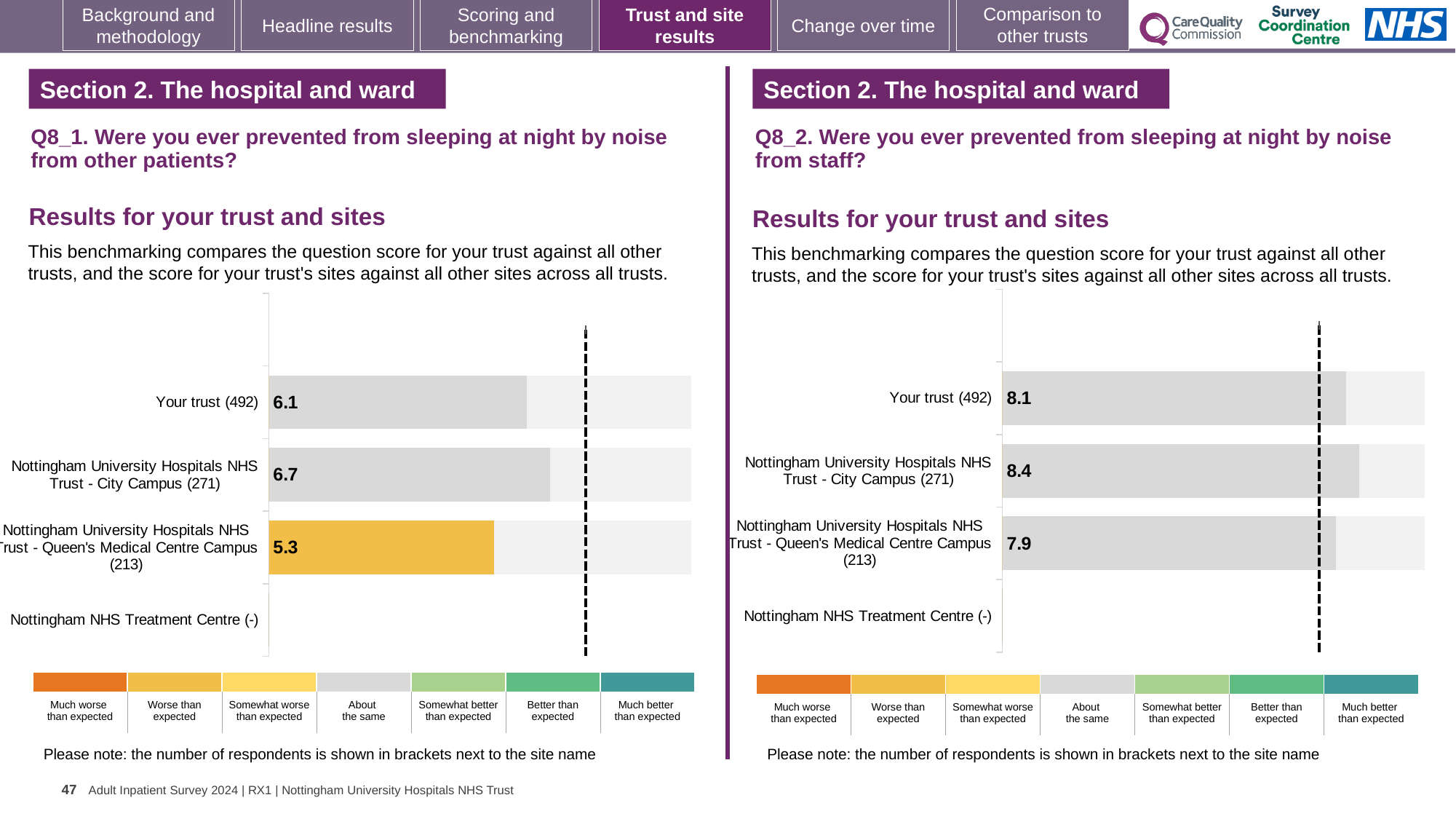
On the Q8_2 chart (noise from staff), what is the difference between the City Campus score and Your trust score? 0.3 On the Q8_1 chart (noise from other patients), which site or trust has the highest score? Nottingham University Hospitals NHS Trust - City Campus (271) How many rows (sites or trust) are listed on the Q8_2 chart (noise from staff)? 4 What kind of chart is used on the left-hand Q8_1 chart? Bar chart On the Q8_1 chart (noise from other patients), which is larger: the score for Your trust or the score for Queen's Medical Centre Campus? Your trust On the Q8_1 chart (noise from other patients), what is the score for Your trust (492)? 6.1 On the Q8_1 chart (noise from other patients), what is the difference between the City Campus score and the Queen's Medical Centre Campus score? 1.4 On the Q8_1 chart (noise from other patients), which bar is coloured yellow/orange rather than grey? Nottingham University Hospitals NHS Trust - Queen's Medical Centre Campus (213) On the Q8_1 chart (noise from other patients), what is the score for Nottingham University Hospitals NHS Trust - Queen's Medical Centre Campus (213)? 5.3 On the Q8_2 chart (noise from staff), what is the score for Your trust (492)? 8.1 On the Q8_2 chart (noise from staff), which site or trust has the lowest score? Nottingham University Hospitals NHS Trust - Queen's Medical Centre Campus (213) On the Q8_2 chart (noise from staff), what is the score for Nottingham University Hospitals NHS Trust - City Campus (271)? 8.4